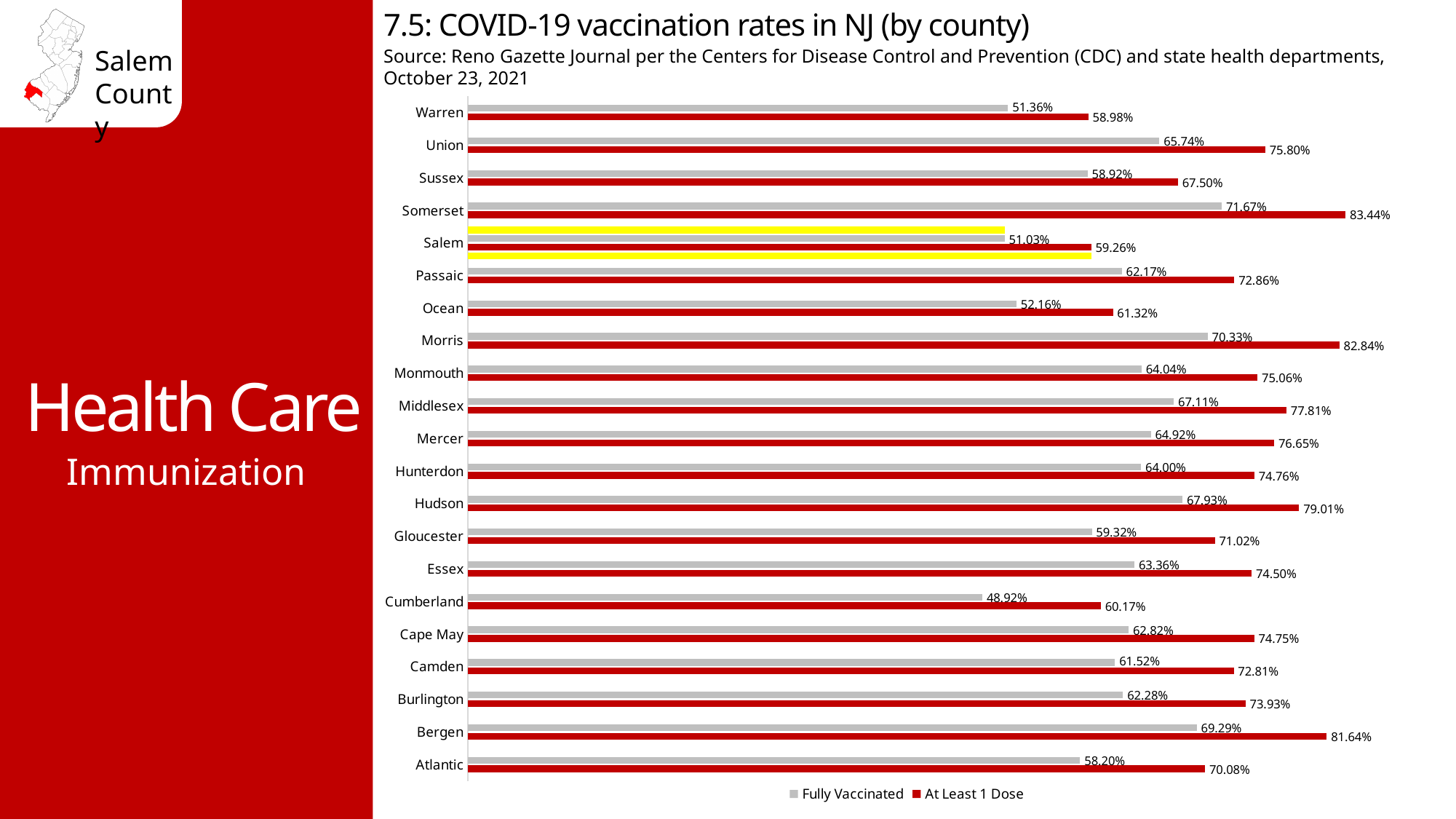
Which county has the lowest At Least 1 Dose rate? Warren Which county has the highest Fully Vaccinated rate? Somerset What is the difference between the At Least 1 Dose rate and the Fully Vaccinated rate for Salem county? 8.23 percentage points Which county's bars are highlighted in yellow on the chart? Salem How many counties are shown in the chart? 21 What is the At Least 1 Dose rate for Cumberland county? 60.17% Which county has the lowest Fully Vaccinated rate? Cumberland What is the Fully Vaccinated rate for Salem county? 51.03% Which county has a higher Fully Vaccinated rate, Bergen or Hudson? Bergen How many series does the legend list? 2 What type of chart is shown on the slide? Bar chart What is the At Least 1 Dose rate for Somerset county? 83.44%